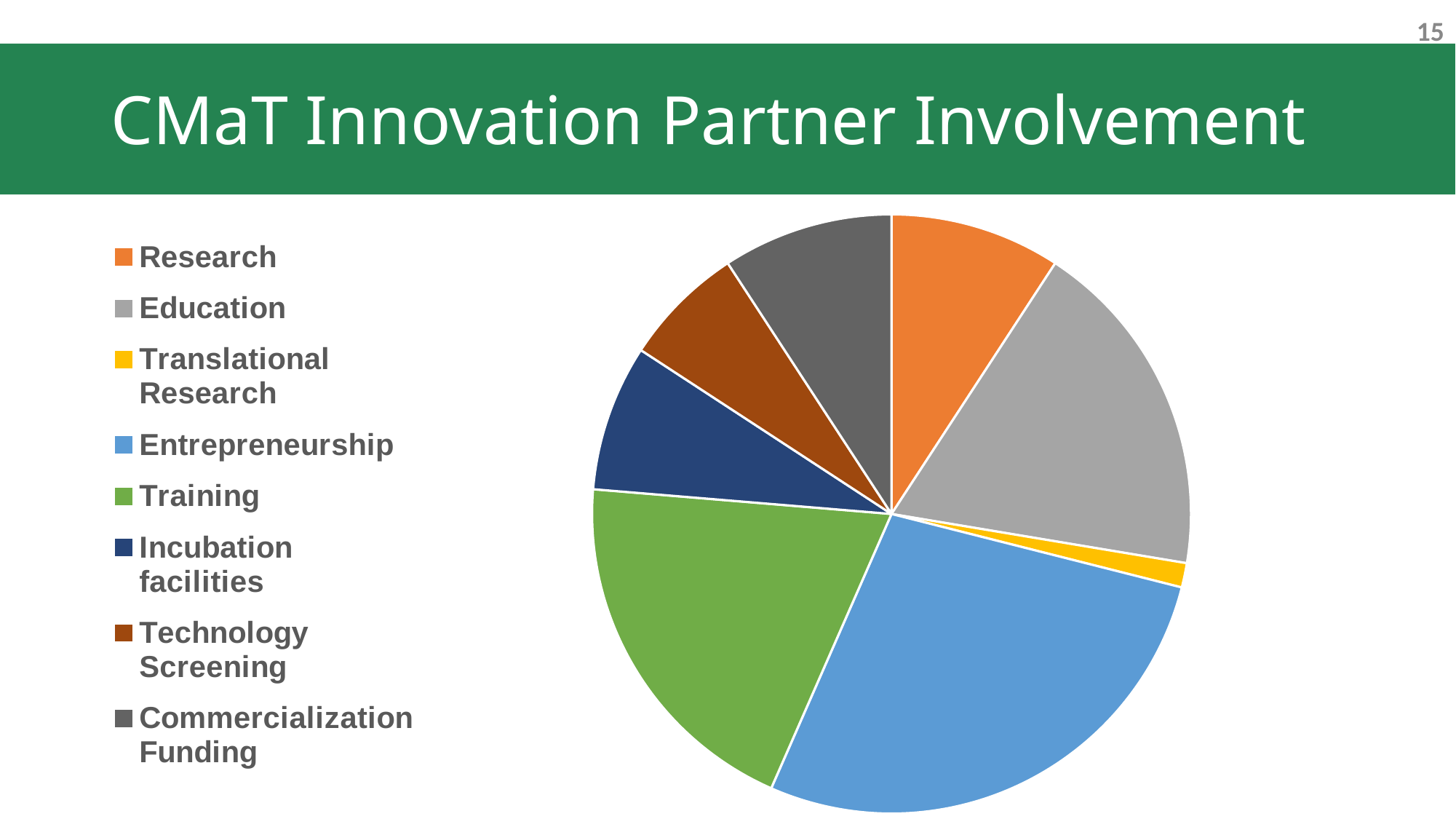
Which category is shown in yellow in the pie chart? Translational Research How many categories does the pie chart show? 8 What kind of chart is shown on the slide? Pie chart Which slice is larger, Entrepreneurship or Education? Entrepreneurship Which slice is larger, Training or Research? Training Which slice is larger, Research or Translational Research? Research What is the title of the slide containing the pie chart? CMaT Innovation Partner Involvement Which category has the smallest slice of the pie chart? Translational Research Which category has the largest slice of the pie chart? Entrepreneurship